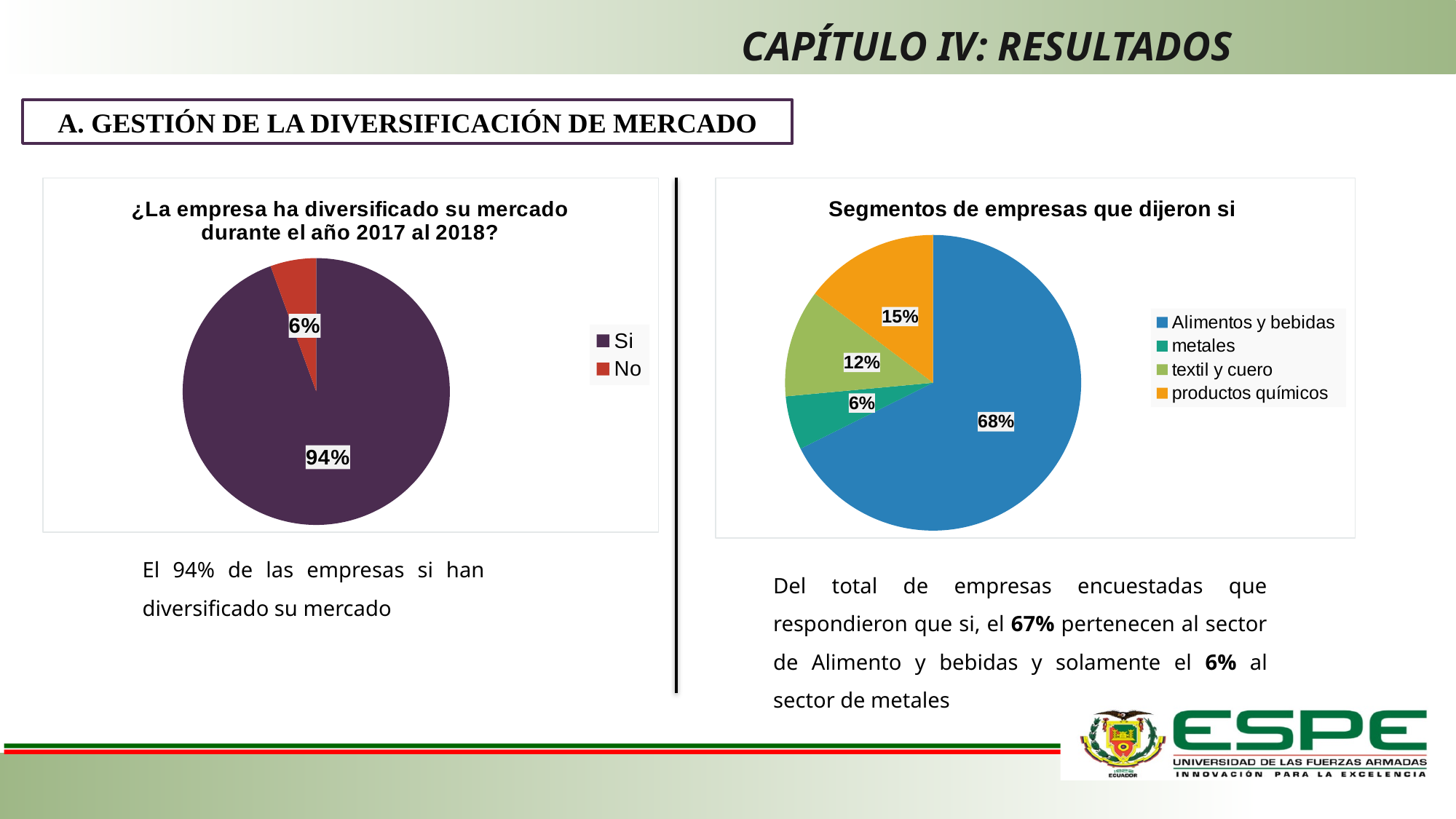
In the right chart 'Segmentos de empresas que dijeron si', how many segments are shown? 4 How many entries does the legend of the left chart '¿La empresa ha diversificado su mercado durante el año 2017 al 2018?' list? 2 In the right chart 'Segmentos de empresas que dijeron si', what share does 'Alimentos y bebidas' have? 68% In the right chart 'Segmentos de empresas que dijeron si', what share does 'productos químicos' have? 15% In the right chart 'Segmentos de empresas que dijeron si', which segment has the largest share? Alimentos y bebidas In the left chart '¿La empresa ha diversificado su mercado durante el año 2017 al 2018?', what is the difference in percentage points between 'Si' and 'No'? 88 In the right chart 'Segmentos de empresas que dijeron si', which is larger: 'textil y cuero' or 'productos químicos'? productos químicos In the left chart '¿La empresa ha diversificado su mercado durante el año 2017 al 2018?', what percentage of companies answered 'Si'? 94% In the left chart '¿La empresa ha diversificado su mercado durante el año 2017 al 2018?', what percentage of companies answered 'No'? 6% In the right chart 'Segmentos de empresas que dijeron si', what share does 'textil y cuero' have? 12% What kind of chart is the left chart '¿La empresa ha diversificado su mercado durante el año 2017 al 2018?'? Pie chart In the right chart 'Segmentos de empresas que dijeron si', which segment has the smallest share? metales